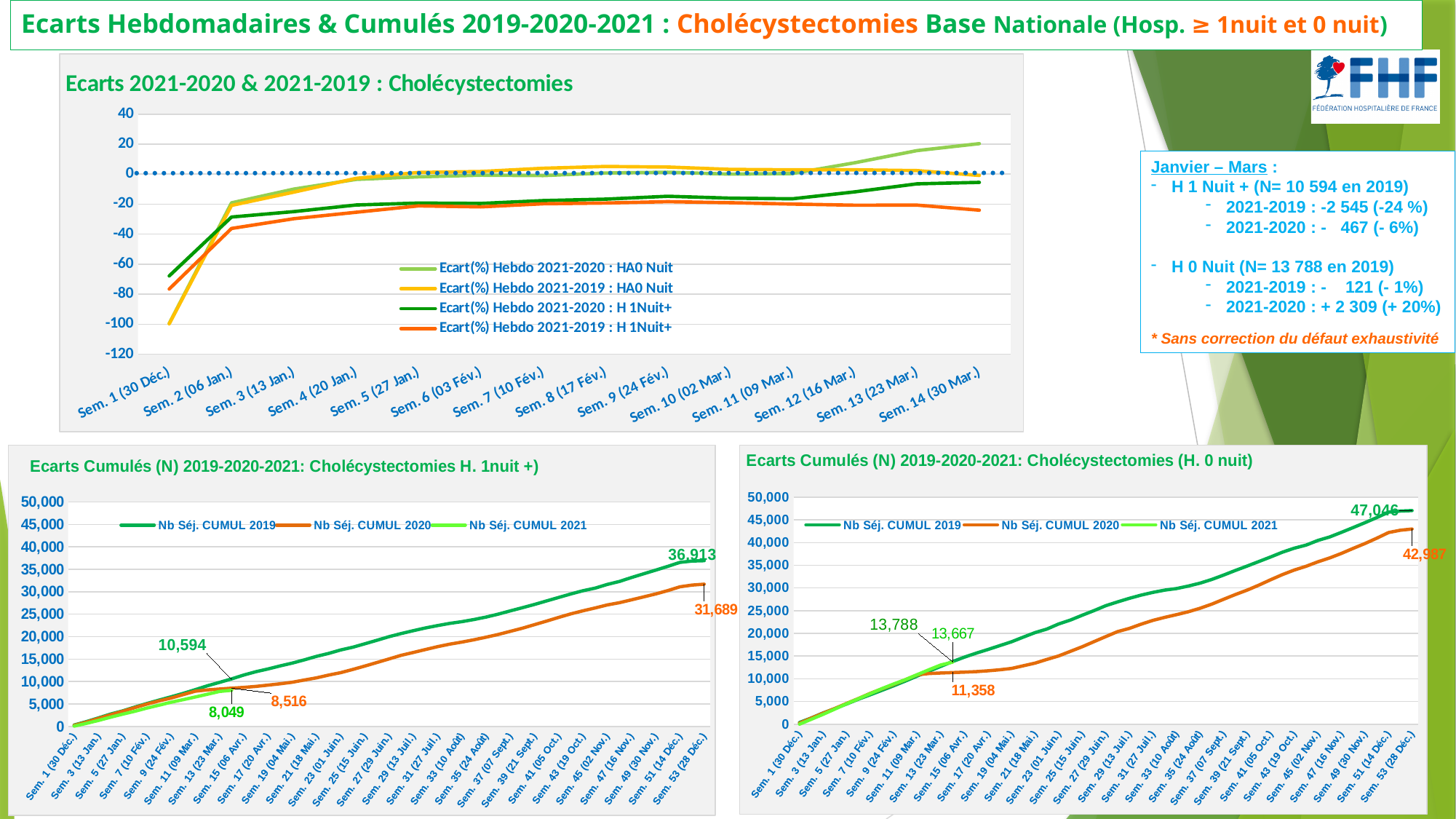
What kind of chart is the top chart titled 'Ecarts 2021-2020 & 2021-2019 : Cholécystectomies'? Line chart In the top chart 'Ecarts 2021-2020 & 2021-2019 : Cholécystectomies', how many series does the legend list? 4 In the bottom-left chart 'Ecarts Cumulés (N) 2019-2020-2021: Cholécystectomies H. 1nuit +', what is the difference between the final labelled values of Nb Séj. CUMUL 2019 (36,913) and Nb Séj. CUMUL 2020 (31,689)? 5,224 In the bottom-right chart 'Ecarts Cumulés (N) 2019-2020-2021: Cholécystectomies (H. 0 nuit)', what is the difference between the Sem. 13 labelled values of Nb Séj. CUMUL 2021 (13,667) and Nb Séj. CUMUL 2020 (11,358)? 2,309 In the bottom-right chart 'Ecarts Cumulés (N) 2019-2020-2021: Cholécystectomies (H. 0 nuit)', what is the final labelled value of Nb Séj. CUMUL 2019? 47,046 In the bottom-right chart 'Ecarts Cumulés (N) 2019-2020-2021: Cholécystectomies (H. 0 nuit)', do the cumulative series rise or fall along the x axis? Rise In the top chart 'Ecarts 2021-2020 & 2021-2019 : Cholécystectomies', how many weeks (Sem.) are shown on the x axis? 14 In the bottom-left chart 'Ecarts Cumulés (N) 2019-2020-2021: Cholécystectomies H. 1nuit +', which is larger at Sem. 13: Nb Séj. CUMUL 2019 (10,594) or Nb Séj. CUMUL 2020 (8,516)? Nb Séj. CUMUL 2019 In the bottom-left chart 'Ecarts Cumulés (N) 2019-2020-2021: Cholécystectomies H. 1nuit +', what is the final labelled value of Nb Séj. CUMUL 2019? 36,913 In the top chart 'Ecarts 2021-2020 & 2021-2019 : Cholécystectomies', is the value of 'Ecart(%) Hebdo 2021-2019 : HA0 Nuit' at Sem. 1 (30 Déc.) greater or less than -80? less In the top chart 'Ecarts 2021-2020 & 2021-2019 : Cholécystectomies', is the value of 'Ecart(%) Hebdo 2021-2020 : HA0 Nuit' at Sem. 14 (30 Mar.) greater or less than 0? greater